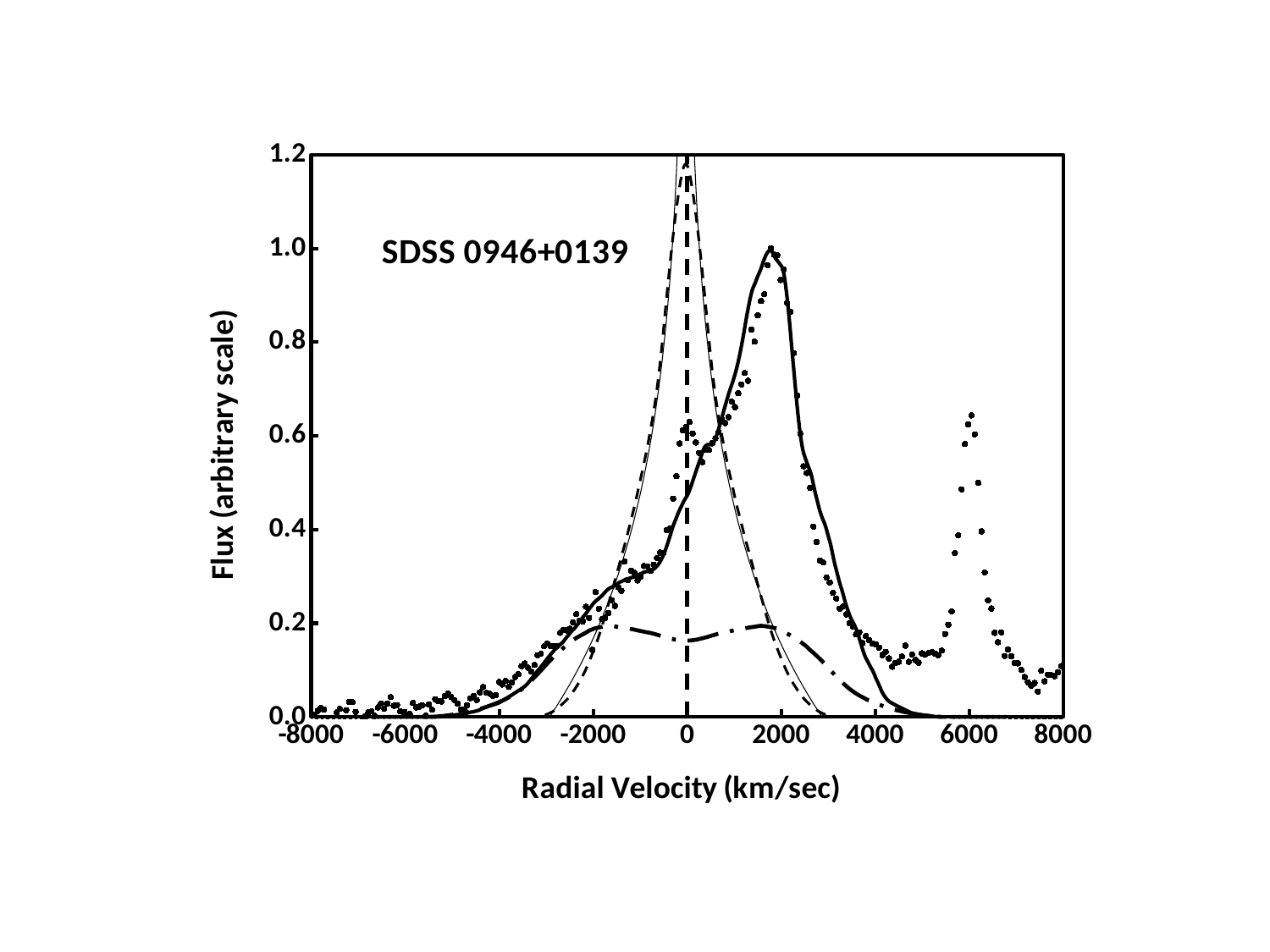
Is the value of the thick solid curve at -6000 km/sec greater or less than 0.2? less What kind of chart is shown on the slide? line chart Which is higher: the peak of the thick solid curve near 2000 km/sec or the peak of the dotted data near 6000 km/sec? the thick solid curve near 2000 km/sec Is the value of the thin solid curve at 0 km/sec greater or less than 1.0? greater What object name is printed as the label inside the chart? SDSS 0946+0139 Do the dotted data values rise or fall between 6000 and 8000 km/sec? fall Does the thick solid curve rise or fall between -8000 and 2000 km/sec? rise Is the peak of the dotted data near 6000 km/sec greater or less than 0.8? less What is the label of the x axis? Radial Velocity (km/sec) What is the highest value labelled on the y axis? 1.2